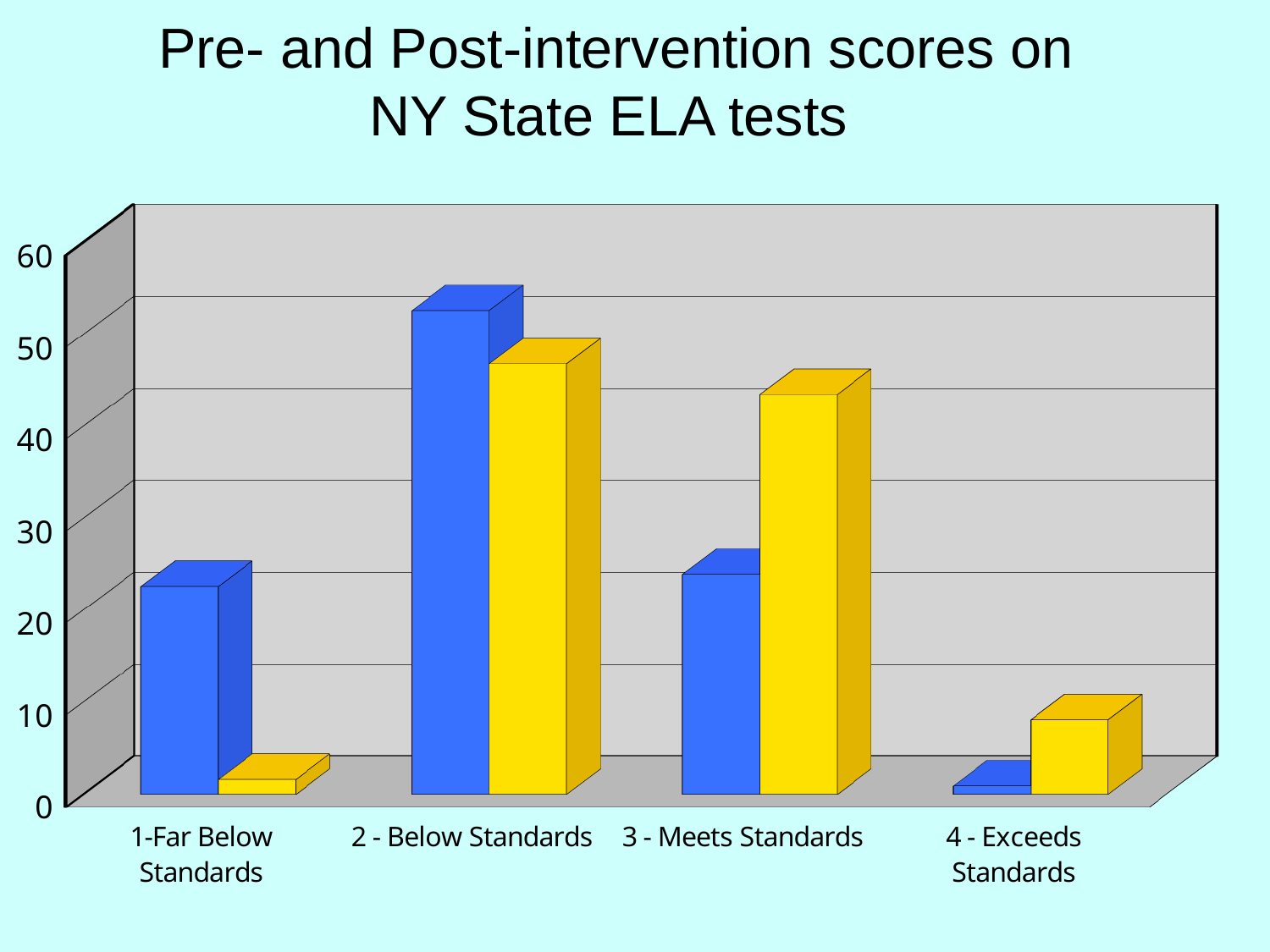
What kind of chart is shown on the slide? bar chart Which category has the shortest yellow bar? 1-Far Below Standards Which category has the tallest yellow bar? 2 - Below Standards For 3 - Meets Standards, which bar is taller, the blue bar or the yellow bar? the yellow bar Which category has the tallest blue bar? 2 - Below Standards What two colours are used for the bars in the chart? blue and yellow Is the yellow bar for 4 - Exceeds Standards greater or less than 10? less How many categories are shown on the x axis of the chart? 4 Which category has the shortest blue bar? 4 - Exceeds Standards Is the yellow bar for 3 - Meets Standards greater or less than 40? greater What is the title of the chart on the slide? Pre- and Post-intervention scores on NY State ELA tests Is the blue bar for 2 - Below Standards greater or less than 50? greater